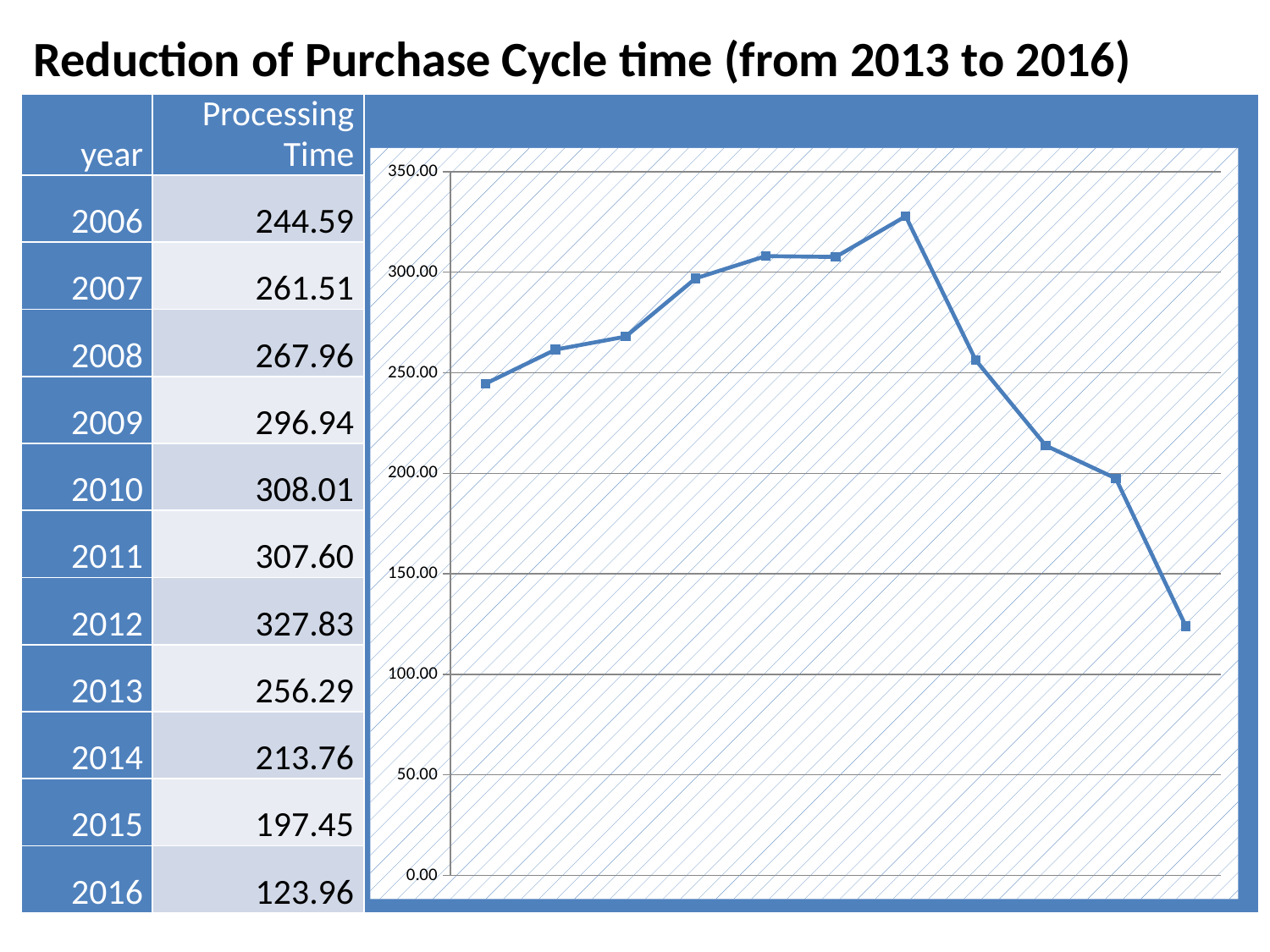
How many data points are plotted on the line chart? 11 Which is larger, the processing time for 2009 or for 2013? 2009 Which year has the lowest processing time? 2016 What type of chart is shown on the slide? line chart Is the value of the last plotted point greater or less than 150.00? less What is the difference in processing time between 2012 and 2016? 203.87 What is the processing time for 2012? 327.83 Do the plotted values rise or fall from 2012 to 2016? fall Which year has the highest processing time? 2012 What is the title of the slide? Reduction of Purchase Cycle time (from 2013 to 2016) What is the processing time for 2006? 244.59 What is the processing time for 2016? 123.96